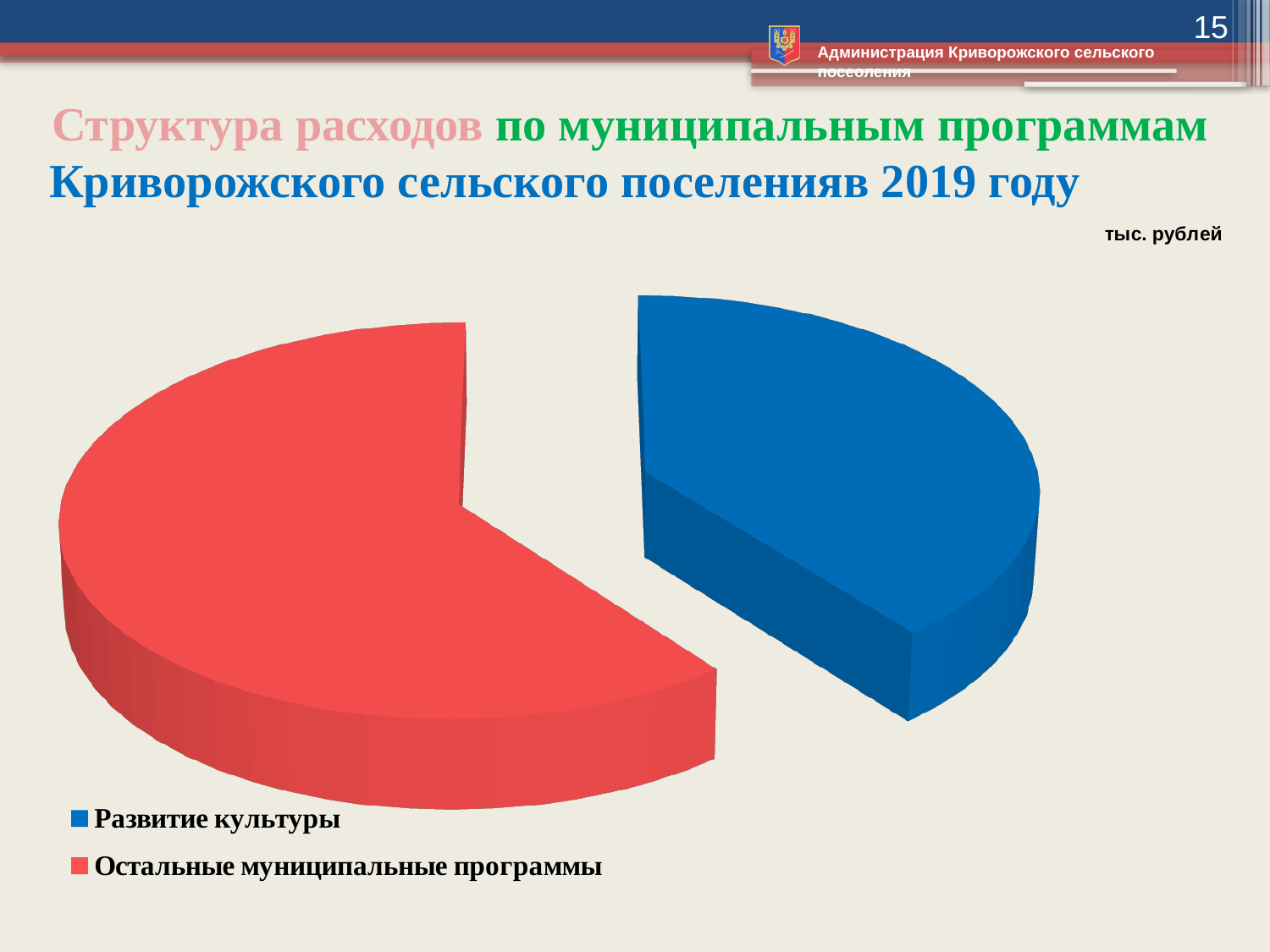
What unit is indicated for the chart values? тыс. рублей What colour is the slice for Развитие культуры? blue How many slices does the pie chart have? 2 Which category has the smallest slice of the pie? Развитие культуры What kind of chart is shown on the slide? pie chart Which slice is larger: Развитие культуры or Остальные муниципальные программы? Остальные муниципальные программы How many entries does the legend list? 2 Which category has the largest slice of the pie? Остальные муниципальные программы